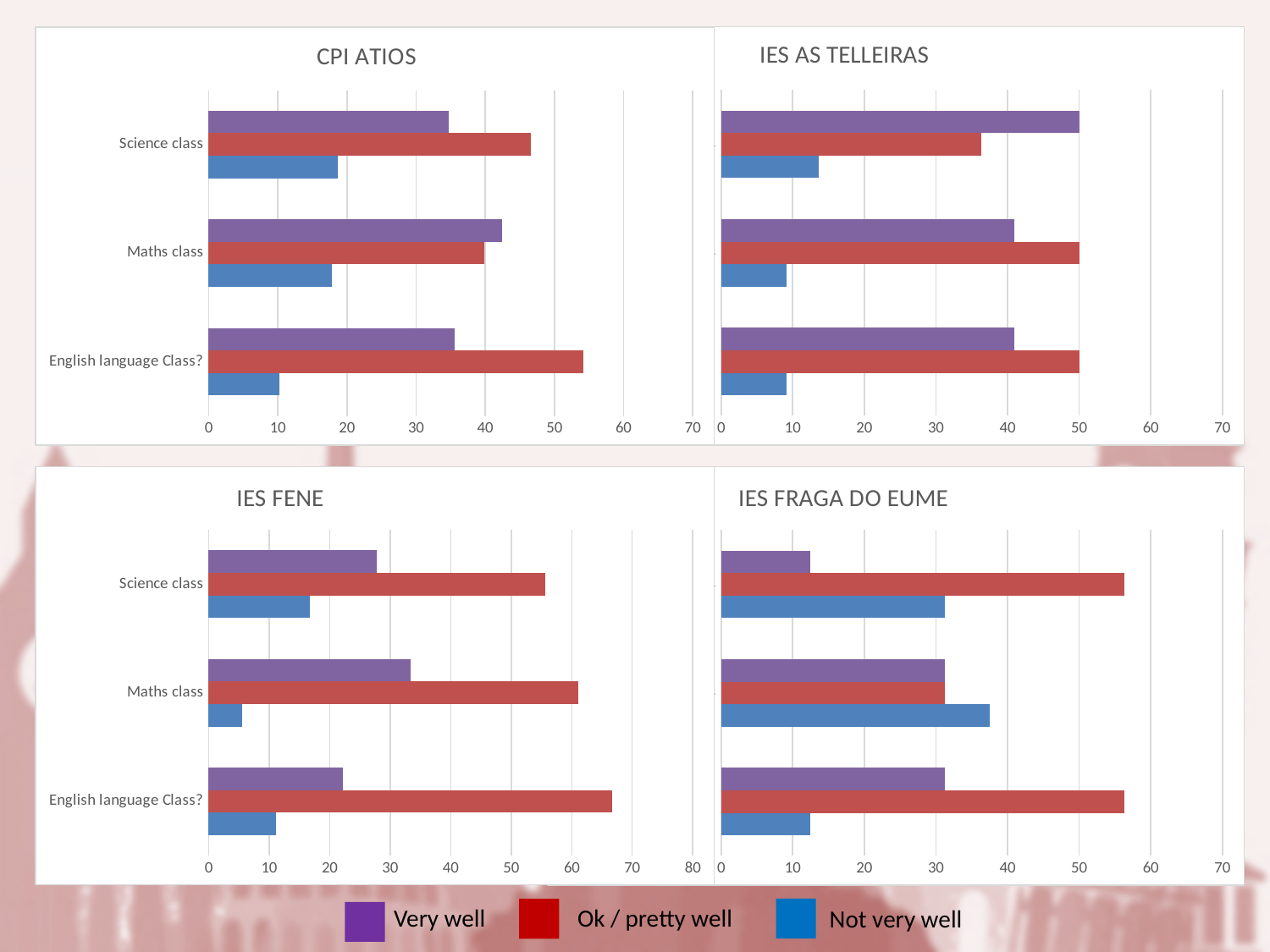
On the IES AS TELLEIRAS chart, what is the value for Very well in Science class? 50 What kind of chart is the IES FENE chart? bar chart How many categories are shown on the CPI ATIOS chart? 3 On the CPI ATIOS chart, in Science class, which is larger: Very well or Ok / pretty well? Ok / pretty well How many series does the legend at the bottom of the slide list? 3 On the IES FENE chart, is the value for Not very well in Maths class greater or less than 10? less On the IES FRAGA DO EUME chart, is the value for Ok / pretty well in Science class greater or less than 50? greater On the CPI ATIOS chart, is the value for Ok / pretty well in English language Class? greater or less than 50? greater On the IES FRAGA DO EUME chart, which category has the lowest value for Very well? Science class On the IES AS TELLEIRAS chart, what is the value for Ok / pretty well in Maths class? 50 On the IES FENE chart, which category has the highest value for Ok / pretty well? English language Class? Which colour represents Not very well in the legend? blue